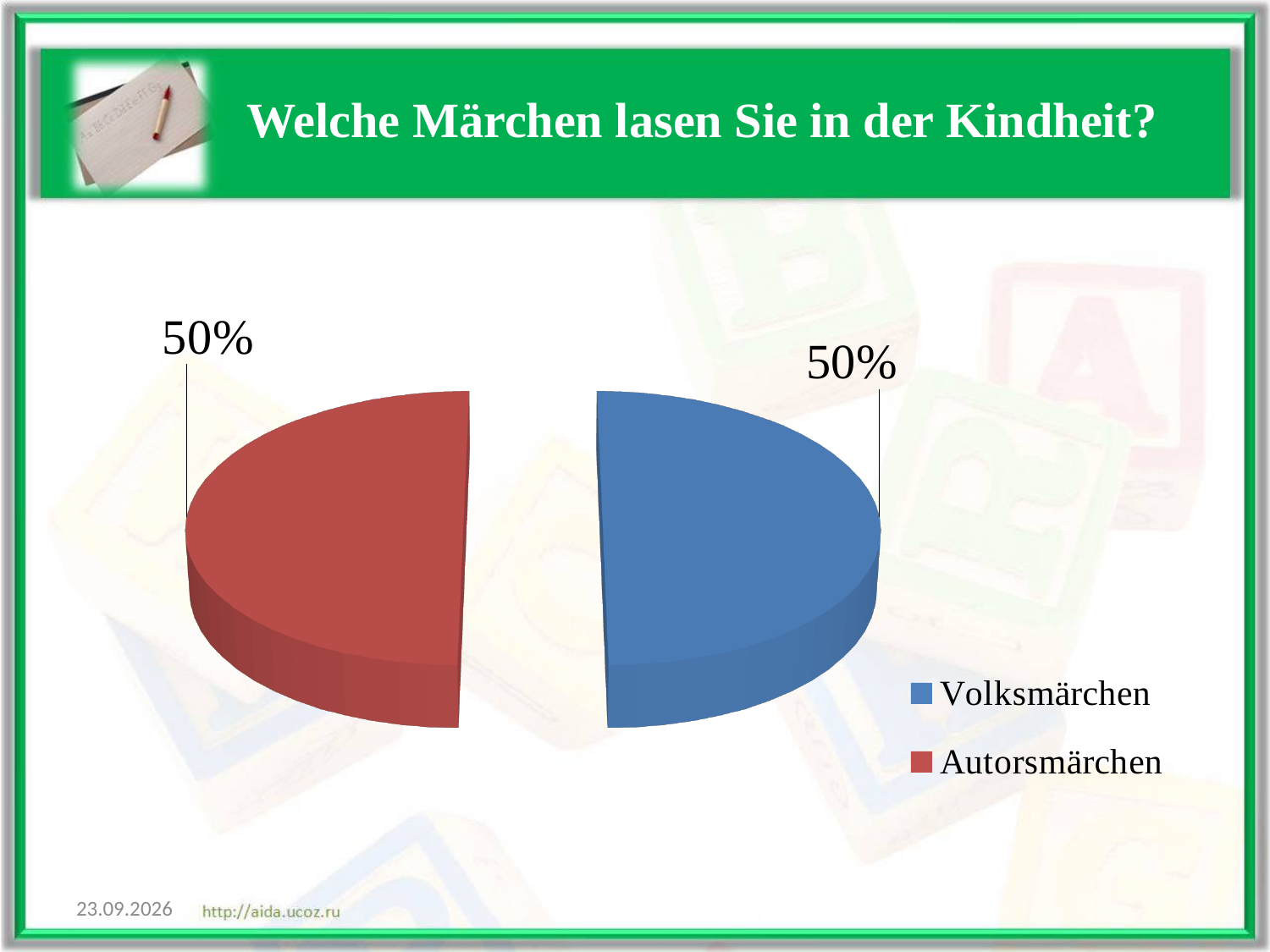
What share of the pie does Autorsmärchen have? 50% How many entries does the legend list? 2 What kind of chart is shown on the slide? pie chart What is the total of the two slices shown in the pie chart? 100% Which colour represents Volksmärchen in the pie chart? blue What is the difference between the shares of Volksmärchen and Autorsmärchen? 0% Which colour represents Autorsmärchen in the pie chart? red What share of the pie does Volksmärchen have? 50% How many slices does the pie chart have? 2